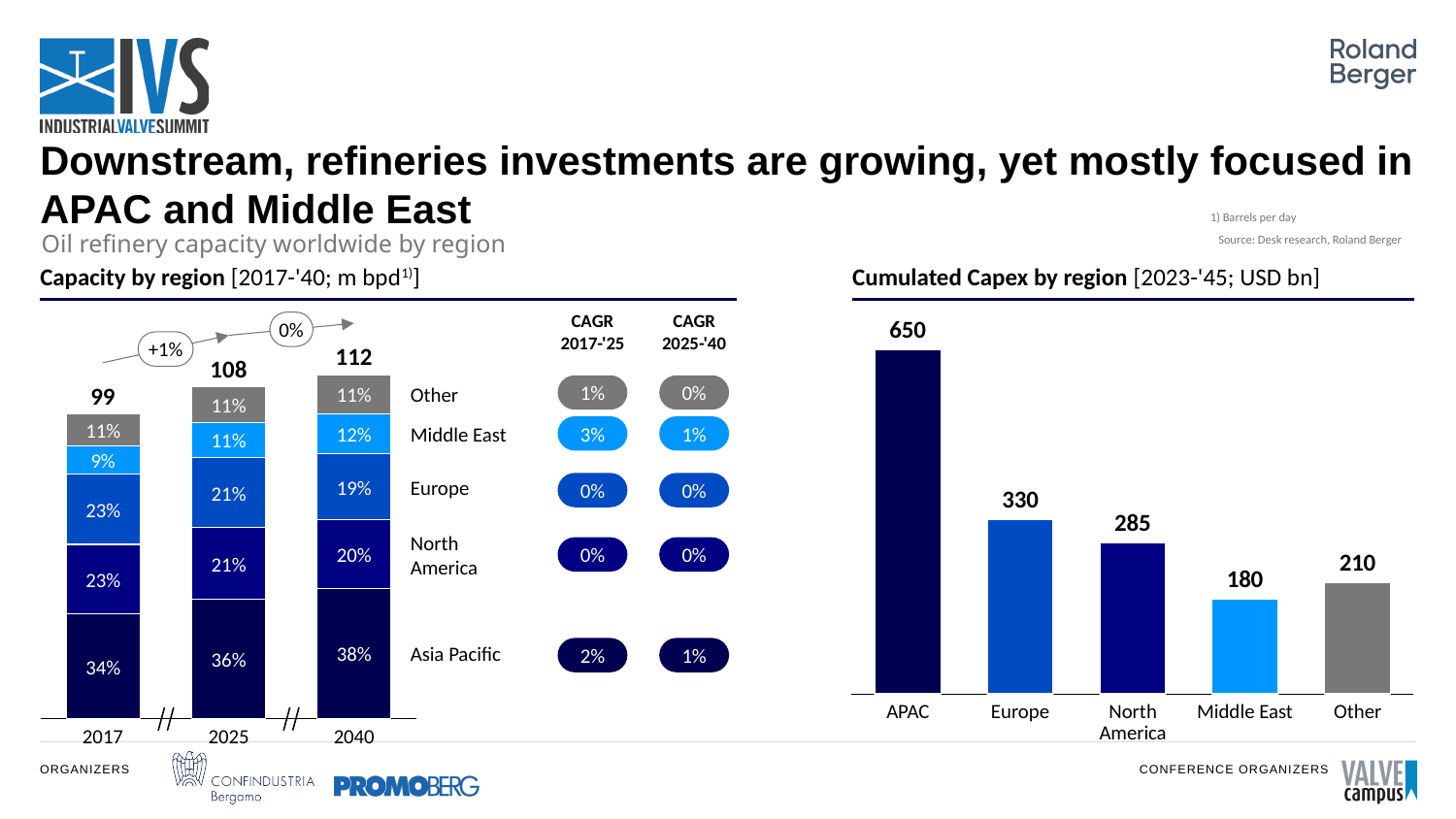
In the 'Cumulated Capex by region' chart, which region has the lowest cumulated capex? Middle East What kind of chart is the 'Cumulated Capex by region' chart? Bar chart In the 'Capacity by region' chart, what is the Middle East share in 2017? 9% In the 'Cumulated Capex by region' chart, which region has the highest cumulated capex? APAC In the 'Cumulated Capex by region' chart, which is larger, the value for Other or the value for Middle East? Other In the 'Capacity by region' chart, what share of capacity does Asia Pacific hold in 2025? 36% In the 'Capacity by region' chart, what is the CAGR for Middle East over 2017-'25? 3% In the 'Cumulated Capex by region' chart, how many regions are shown? 5 In the 'Cumulated Capex by region' chart, what is the difference between the values for Europe and North America? 45 In the 'Capacity by region' chart, does the total capacity rise or fall from 2017 to 2040? Rise In the 'Cumulated Capex by region' chart, what is the value for APAC? 650 In the 'Capacity by region' chart, what is the total capacity shown for 2040? 112